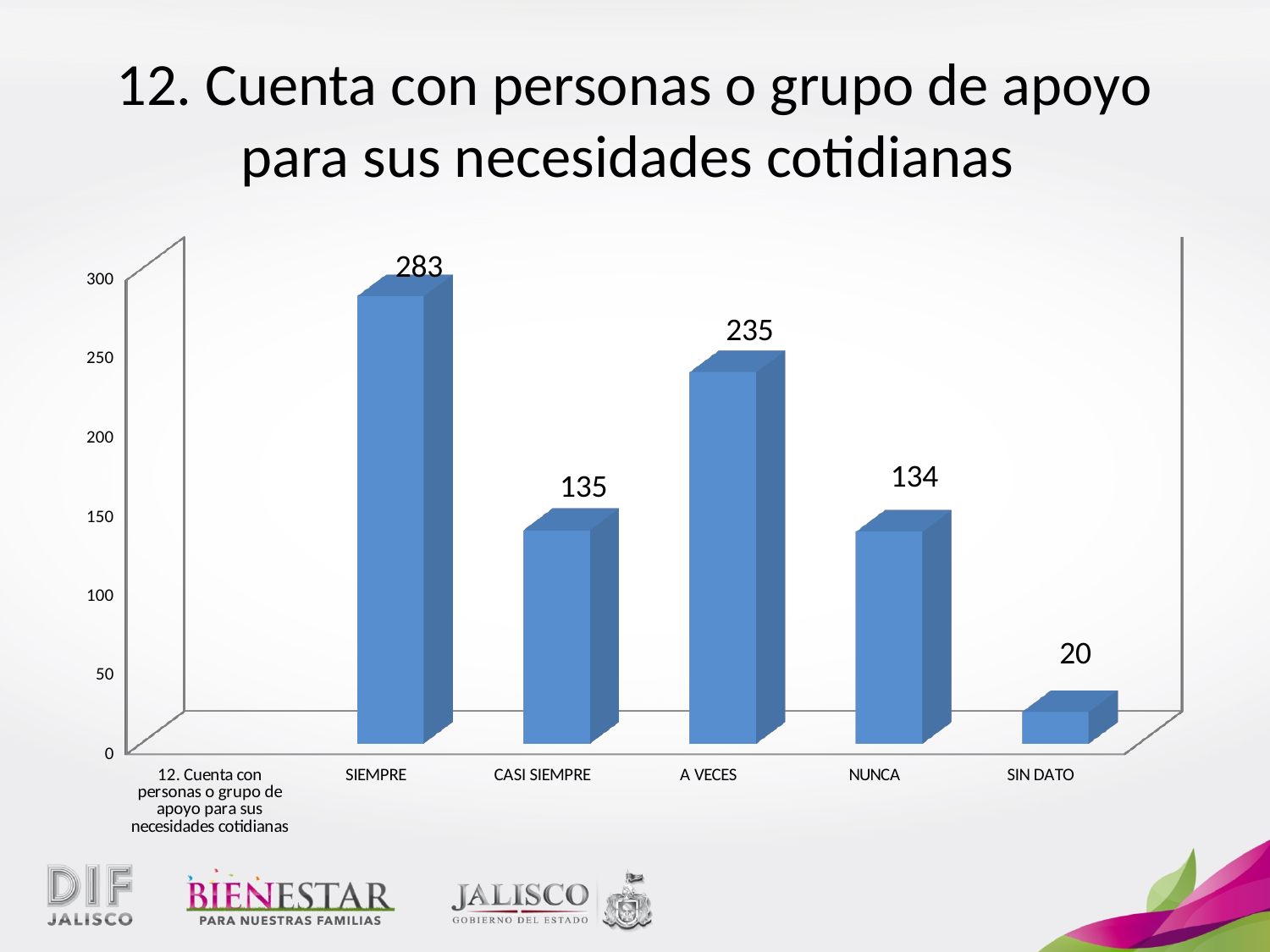
What is the value for CASI SIEMPRE? 135 What is the value for SIN DATO? 20 What is the difference between the values for A VECES and CASI SIEMPRE? 100 What is the difference between the values for SIEMPRE and A VECES? 48 What is the value for A VECES? 235 What kind of chart is shown on the slide? bar chart Which category has the lowest value? SIN DATO Which category has the highest value? SIEMPRE What is the value for SIEMPRE? 283 Which is larger, the value for A VECES or the value for NUNCA? A VECES How many bars are plotted in the chart? 5 Is the value for SIEMPRE greater or less than 250? greater